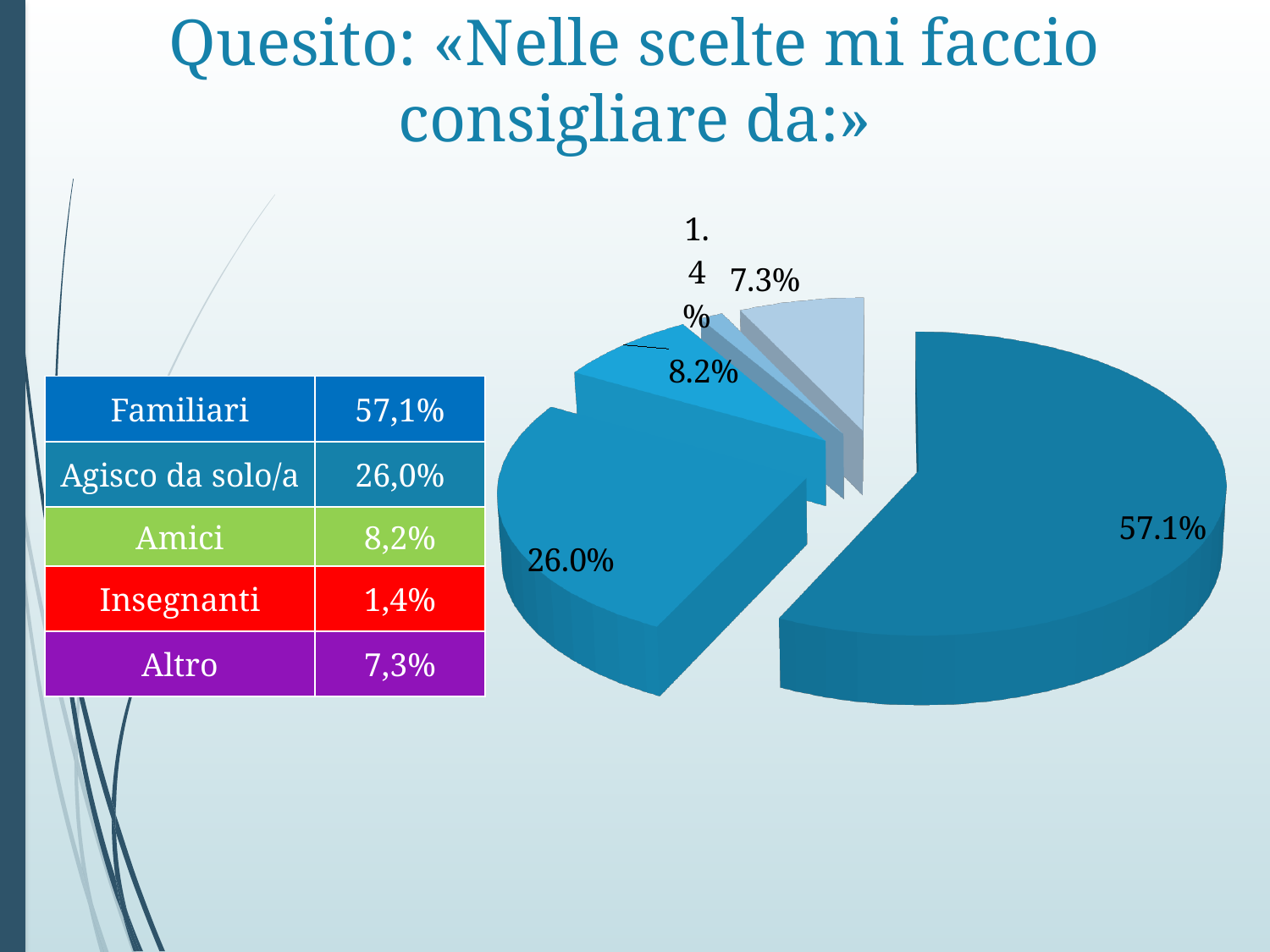
According to the table next to the pie chart, which category has the smallest share? Insegnanti What is the smallest value labelled on the pie chart? 1.4% What is the difference between the largest slice (57.1%) and the second largest slice (26.0%) of the pie chart? 31.1% What is the largest value labelled on the pie chart? 57.1% Which is larger, the share for Amici or the share for Altro? Amici According to the table next to the pie chart, which category has the largest share? Familiari What is the title of the slide containing the pie chart? Quesito: «Nelle scelte mi faccio consigliare da:» What percentage is shown for Agisco da solo/a in the table? 26,0% What percentage is shown for Altro in the table? 7,3% What percentage is shown for Amici in the table? 8,2% How many slices does the pie chart have? 5 What kind of chart is shown on the slide? pie chart